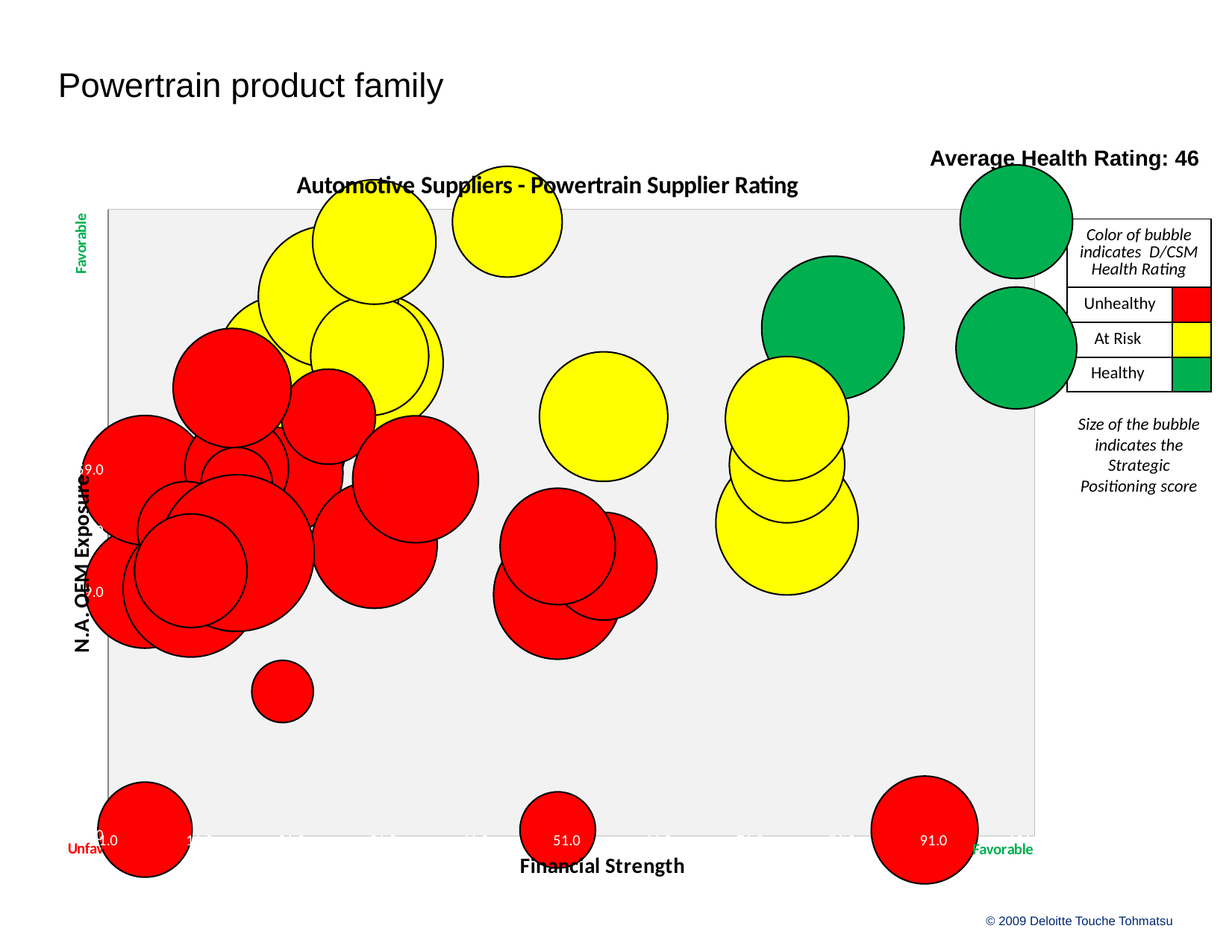
What is the Average Health Rating stated on the slide? 46 Which health rating category is shown in yellow? At Risk Which health rating category is shown in red? Unhealthy How many green (Healthy) bubbles are plotted on the chart? 3 Which health rating category is shown in green? Healthy Which colour of bubble appears most often on the chart? Red How many health rating categories does the legend list? 3 What kind of chart is shown on the slide? Bubble chart